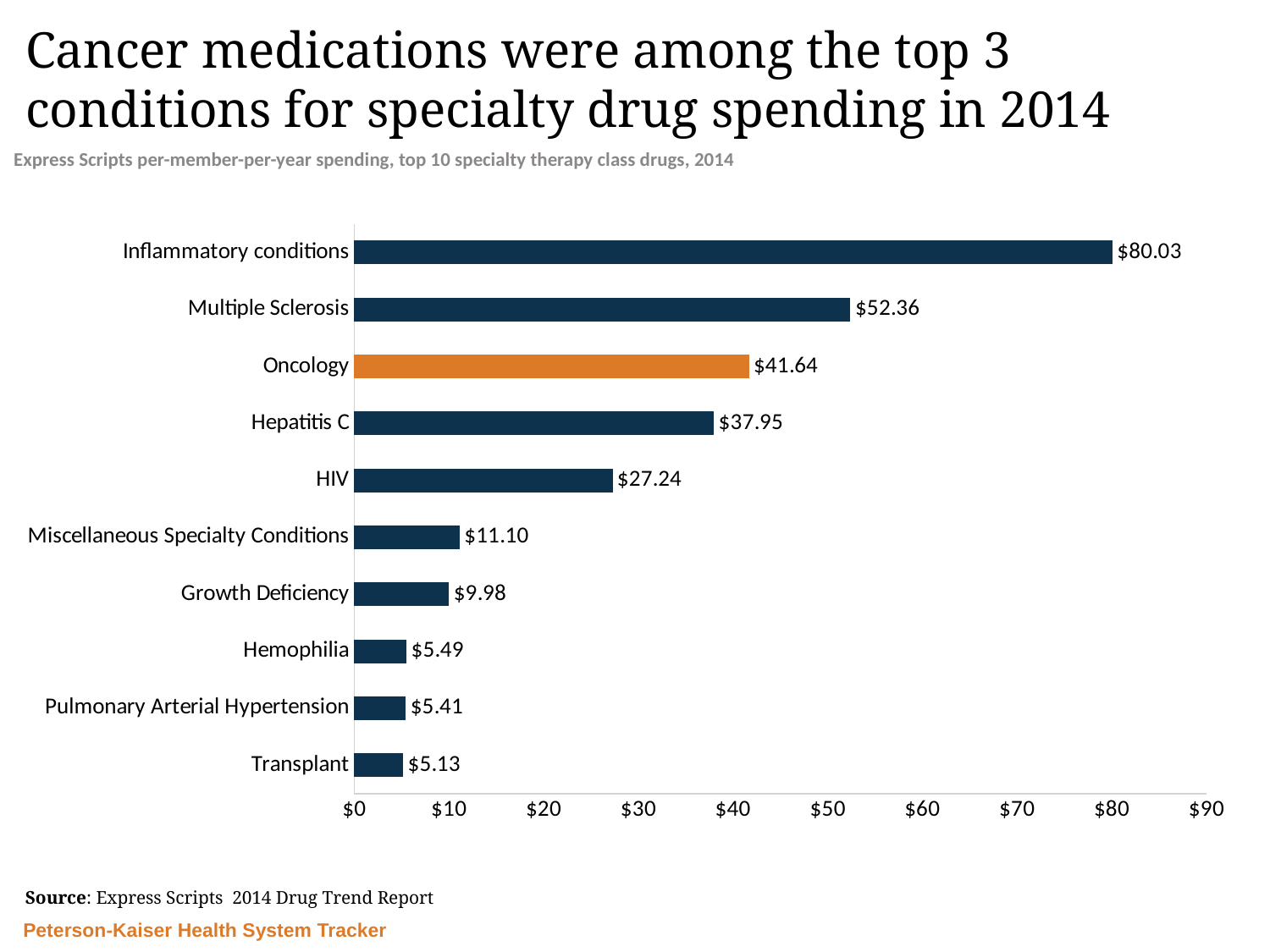
How many conditions are shown in the chart? 10 What kind of chart is shown on the slide? Bar chart Which condition has the lowest spending? Transplant What is the per-member-per-year spending for Oncology? $41.64 Which is larger, the value for Multiple Sclerosis or the value for Oncology? Multiple Sclerosis Is the value for HIV greater or less than $30? less What is the difference between the values for Inflammatory conditions and Multiple Sclerosis? $27.67 Which condition has the highest spending? Inflammatory conditions Which bar is highlighted in orange? Oncology What is the difference between the values for HIV and Miscellaneous Specialty Conditions? $16.14 What is the value shown for Growth Deficiency? $9.98 What is the value shown for Hepatitis C? $37.95